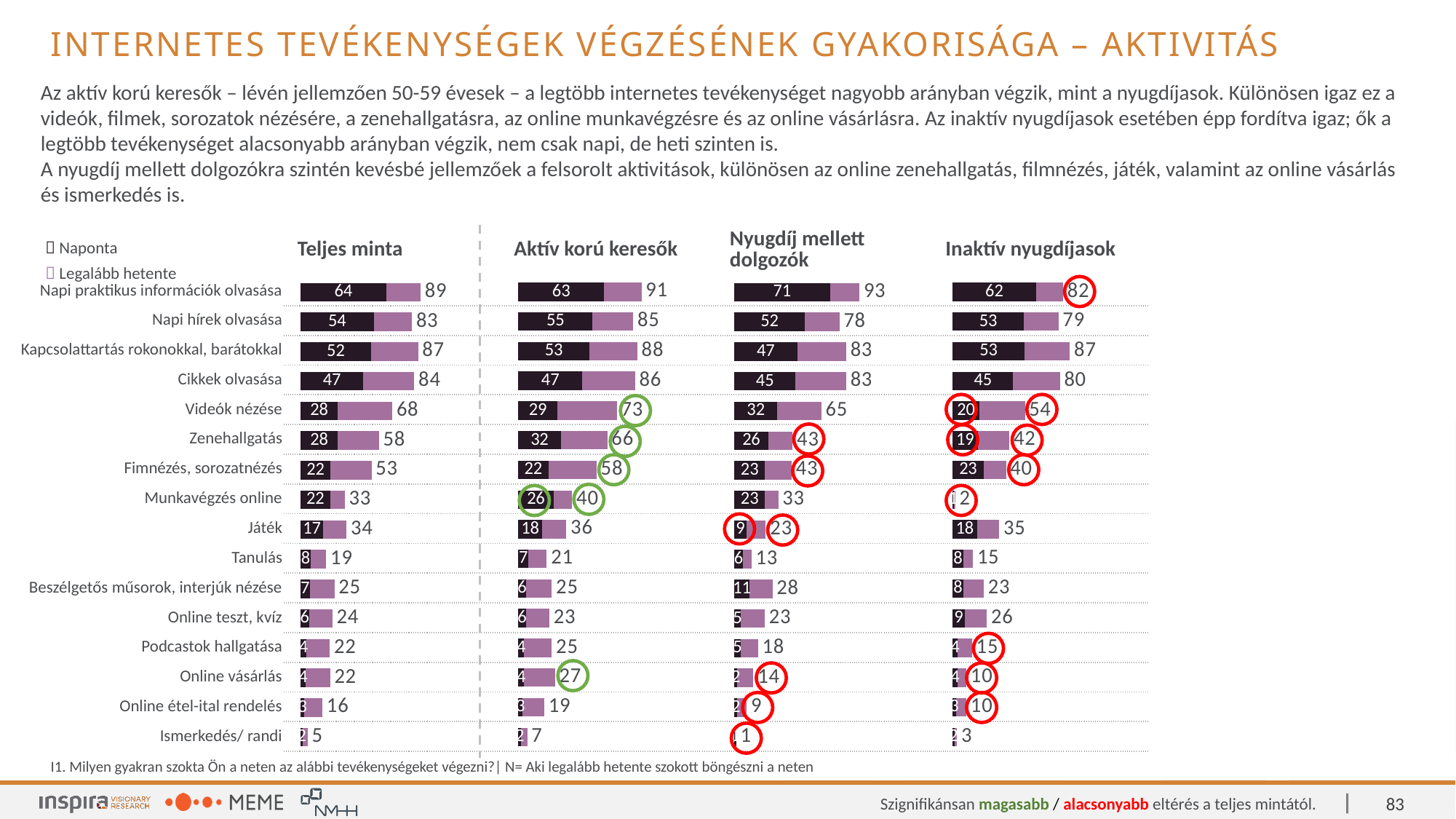
How many series does the legend list? 2 For Videók nézése, which chart shows a higher Legalább hetente value: Aktív korú keresők or Nyugdíj mellett dolgozók? Aktív korú keresők In the Teljes minta chart, which activity has the highest Legalább hetente value? Napi praktikus információk olvasása In the Aktív korú keresők chart, what is the Legalább hetente value for Videók nézése? 73 What are the two legend entries shown on the slide? Naponta, Legalább hetente What kind of chart is the Teljes minta chart? Bar chart In the Teljes minta chart, what is the Naponta value for Napi praktikus információk olvasása? 64 In the Inaktív nyugdíjasok chart, what is the Legalább hetente value for Munkavégzés online? 2 What is the difference between the Legalább hetente value for Zenehallgatás in the Aktív korú keresők chart and in the Inaktív nyugdíjasok chart? 24 How many activities are listed in the Teljes minta chart? 16 In the Nyugdíj mellett dolgozók chart, which activity has the lowest Legalább hetente value? Ismerkedés/ randi In the Nyugdíj mellett dolgozók chart, what is the Naponta value for Játék? 9